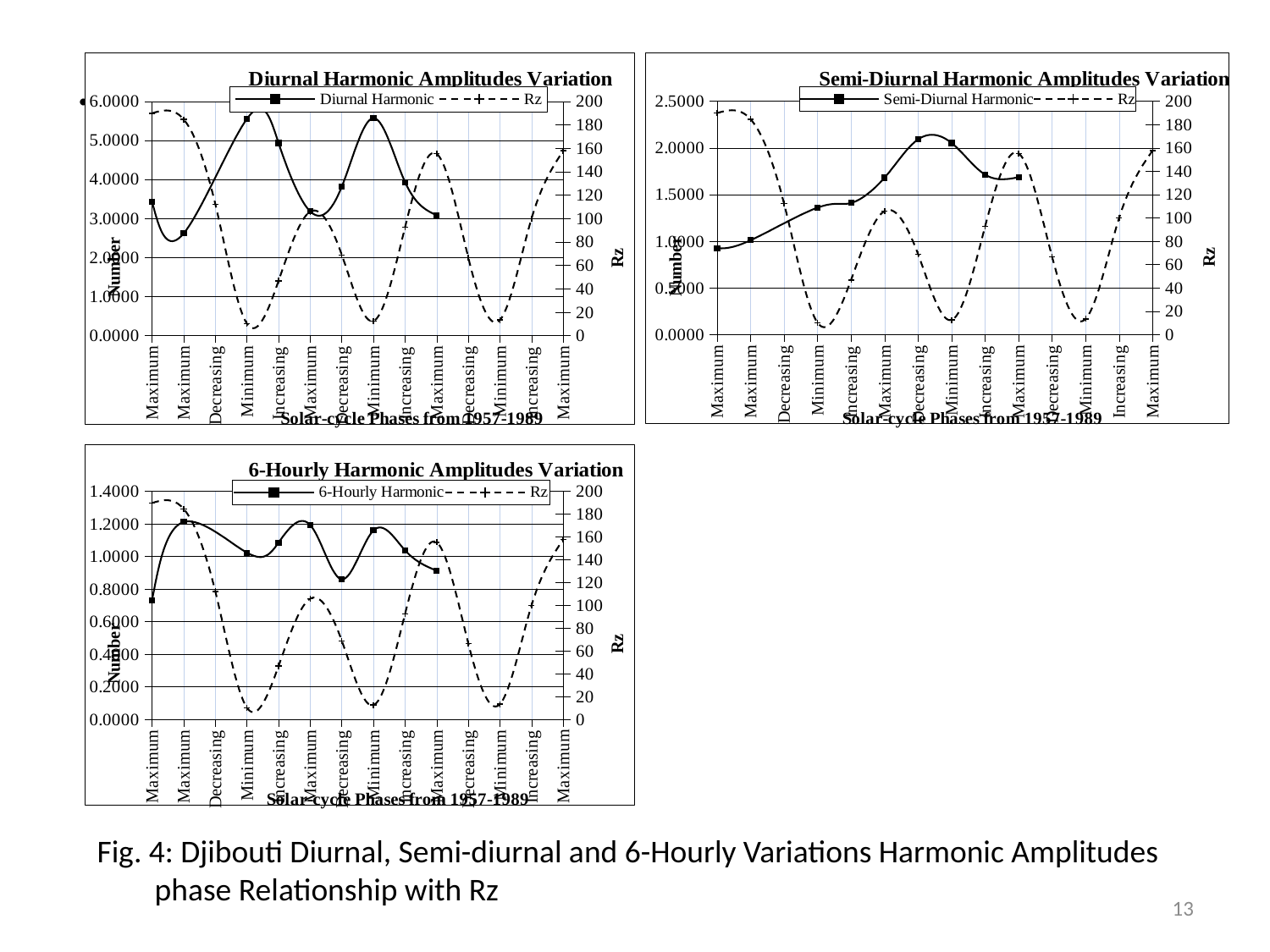
In the '6-Hourly Harmonic Amplitudes Variation' chart, is the Rz value at the first 'Minimum' category greater or less than 40? less In the 'Semi-Diurnal Harmonic Amplitudes Variation' chart, is the Semi-Diurnal Harmonic value at the first category greater or less than 1.5000? less In the 'Diurnal Harmonic Amplitudes Variation' chart, which series is plotted with a dashed line? Rz How many series does the legend of the 'Semi-Diurnal Harmonic Amplitudes Variation' chart list? 2 What is the x-axis title of the 'Semi-Diurnal Harmonic Amplitudes Variation' chart? Solar-cycle Phases from 1957-1989 In the '6-Hourly Harmonic Amplitudes Variation' chart, is the 6-Hourly Harmonic value at the first category greater or less than 1.0000? less What kind of chart is the 'Diurnal Harmonic Amplitudes Variation' chart? line chart In the '6-Hourly Harmonic Amplitudes Variation' chart, how many categories are shown on the x axis? 14 How many charts are shown on the slide? 3